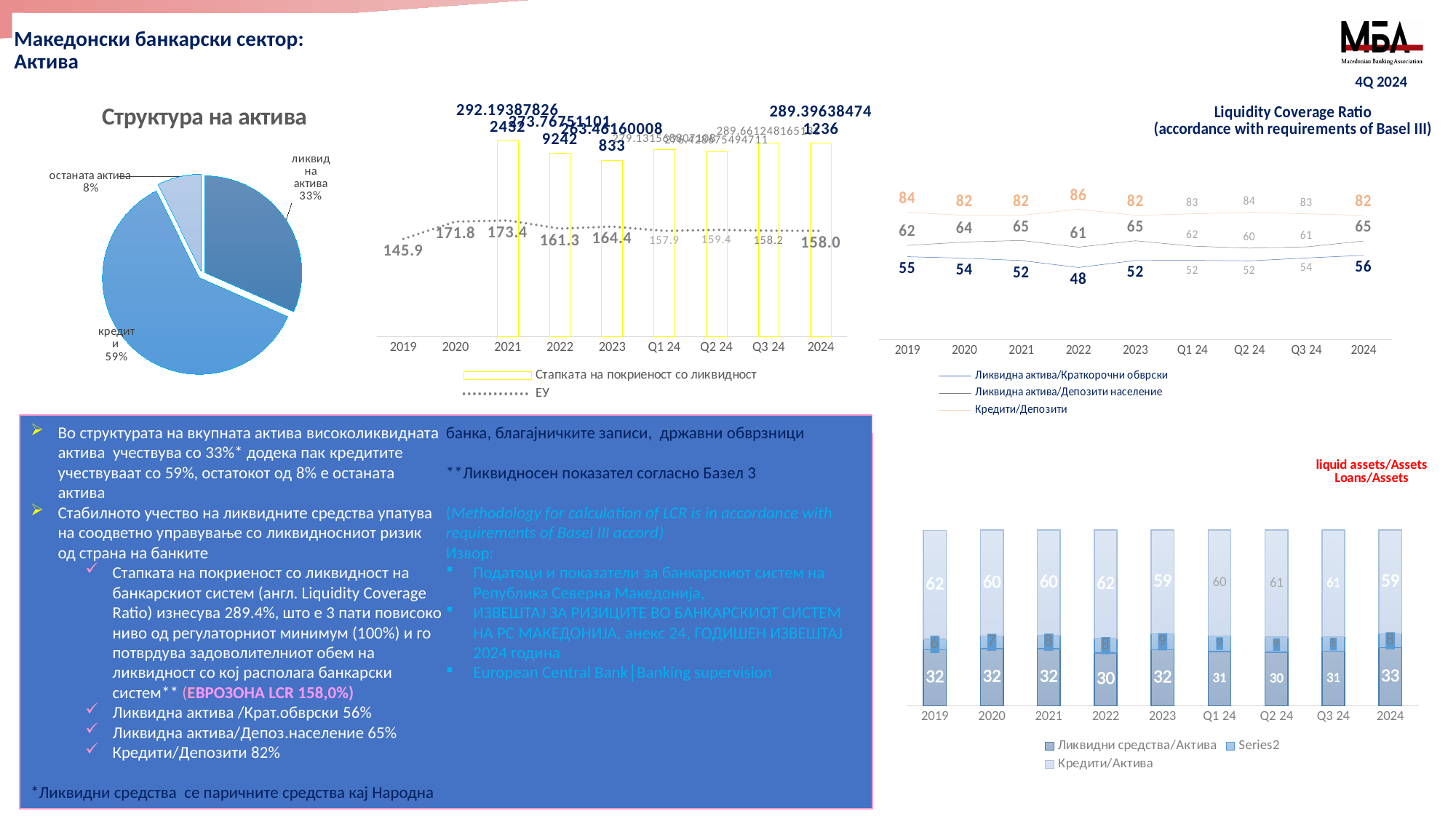
In the pie chart 'Структура на актива', which slice is the largest? кредити In the middle chart with the yellow bars, what is the value of the 'ЕУ' line for 2019? 145.9 In the pie chart 'Структура на актива', what share is 'останата актива'? 8% In the 'Liquidity Coverage Ratio' line chart, what is the difference between 'Ликвидна актива/Депозити население' and 'Ликвидна актива/Краткорочни обврски' in 2024? 9 In the 'Liquidity Coverage Ratio' line chart, in which year is 'Ликвидна актива/Краткорочни обврски' lowest? 2022 In the 'Liquidity Coverage Ratio' line chart, what is the value of 'Ликвидна актива/Краткорочни обврски' for 2024? 56 In the pie chart 'Структура на актива', how many slices are there? 3 In the pie chart 'Структура на актива', what share of assets is 'кредити'? 59% In the 'Liquidity Coverage Ratio' line chart, what is the value of 'Кредити/Депозити' for 2022? 86 In the bottom-right stacked bar chart, what is the value of 'Ликвидни средства/Актива' for 2024? 33 In the middle chart with the yellow bars, what is the value of the 'ЕУ' line for 2021? 173.4 In the middle chart with the yellow bars, how many categories are shown on the x axis? 9